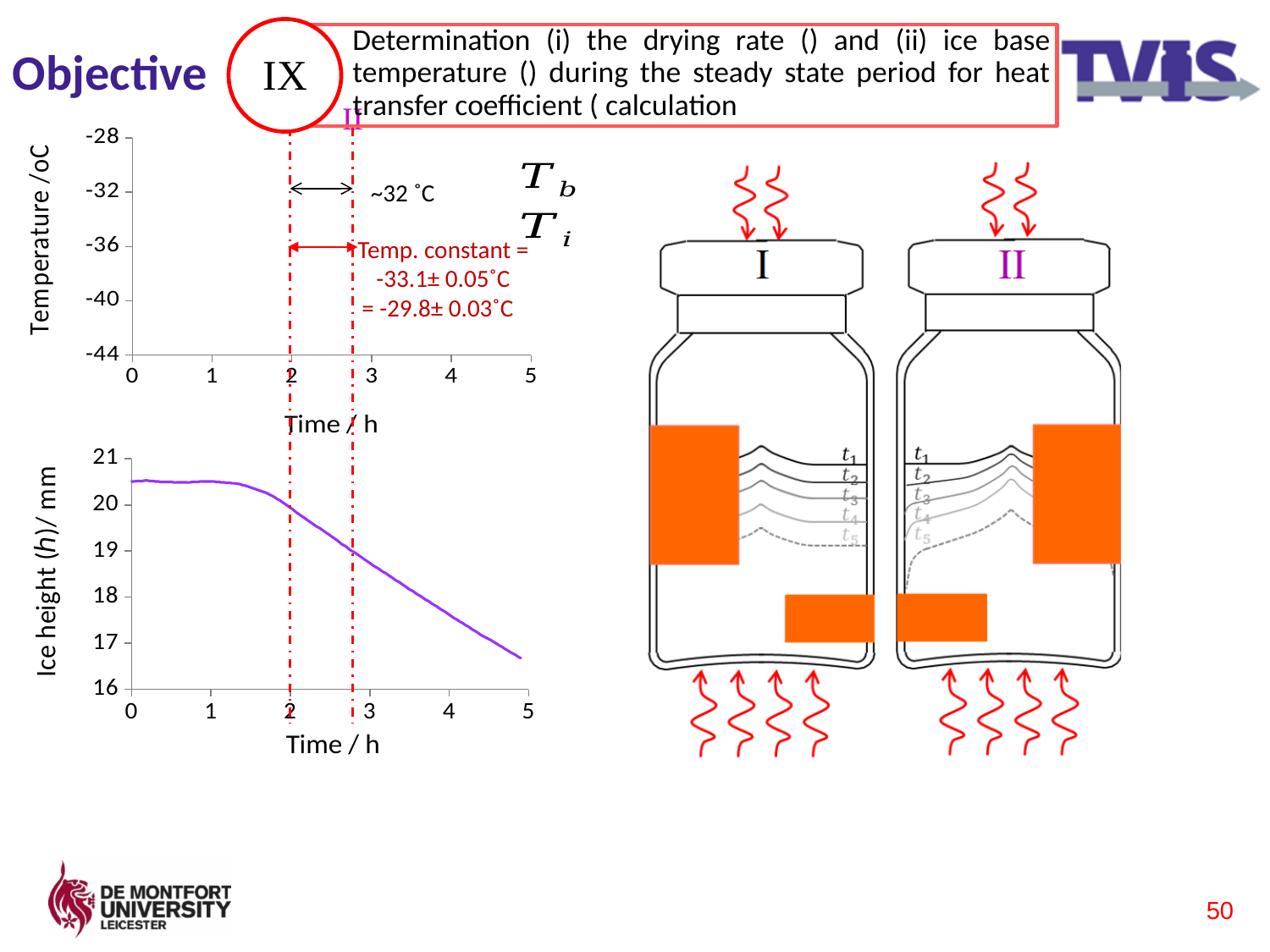
What kind of chart is the bottom chart (Ice height vs Time)? line chart In the bottom chart (Ice height vs Time), is the ice height at 3 h greater or less than 20 mm? less In the bottom chart (Ice height vs Time), is the ice height at time 1 h greater or less than 20 mm? greater In the bottom chart (Ice height vs Time), which is larger: the ice height at 1 h or at 4 h? 1 h In the bottom chart (Ice height vs Time), is the ice height at the end of the line (near 5 h) greater or less than 17 mm? less What is the y-axis label of the bottom chart? Ice height (h)/ mm What is the y-axis label of the top chart? Temperature /oC In the bottom chart (Ice height vs Time), does the ice height rise or fall as time increases? fall